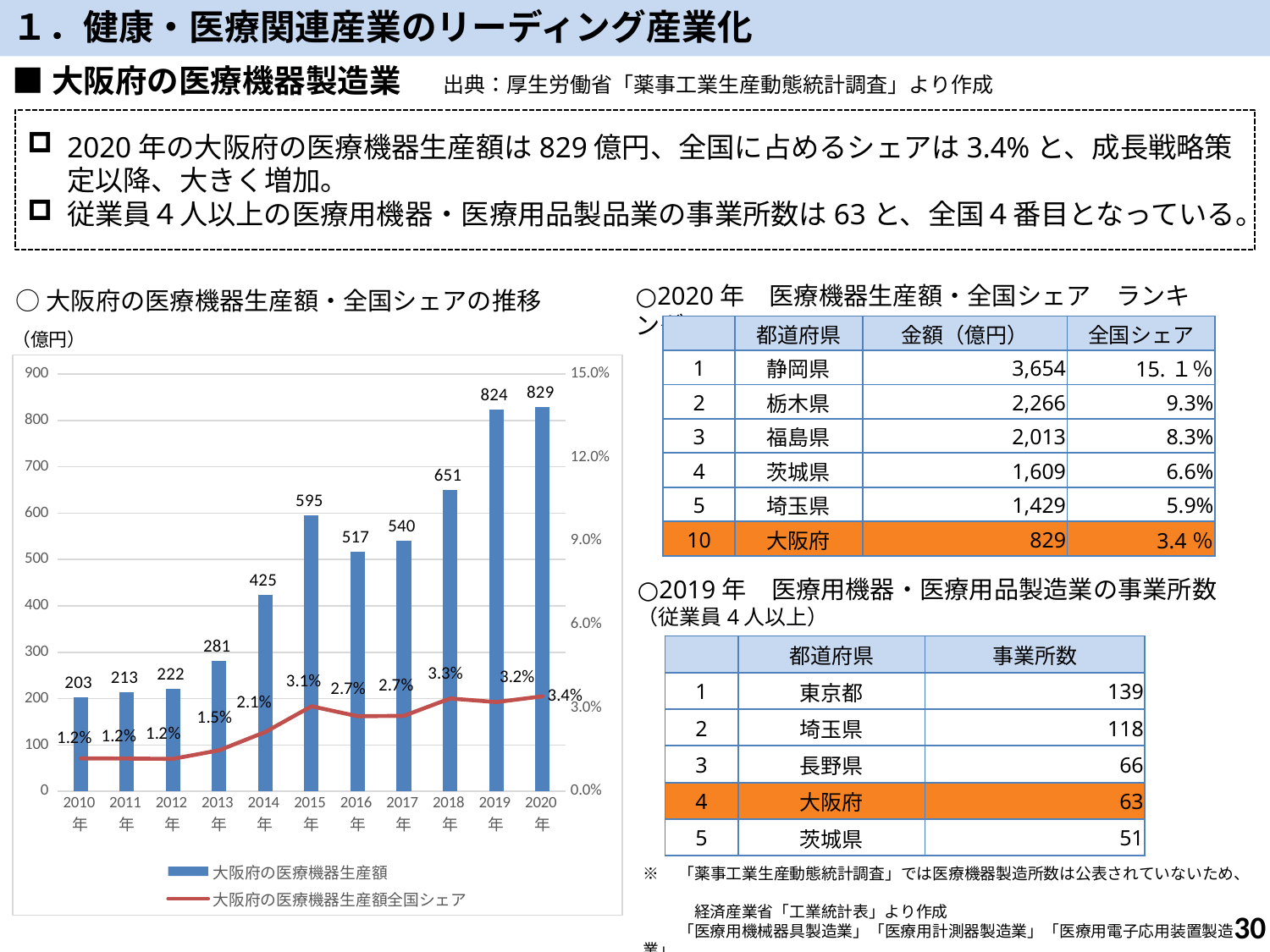
In the chart 大阪府の医療機器生産額・全国シェアの推移, what is the value of 大阪府の医療機器生産額 for 2020年? 829 What kind of chart is 大阪府の医療機器生産額・全国シェアの推移? Bar chart combined with a line chart In the chart 大阪府の医療機器生産額・全国シェアの推移, does 大阪府の医療機器生産額 generally rise or fall from 2010年 to 2020年? Rise In the chart 大阪府の医療機器生産額・全国シェアの推移, what is the difference between the 大阪府の医療機器生産額 values for 2020年 and 2010年? 626 In the chart 大阪府の医療機器生産額・全国シェアの推移, which year has the lowest 大阪府の医療機器生産額? 2010年 In the chart 大阪府の医療機器生産額・全国シェアの推移, how many years are shown on the x axis? 11 In the chart 大阪府の医療機器生産額・全国シェアの推移, how many series does the legend list? 2 In the chart 大阪府の医療機器生産額・全国シェアの推移, what is the 全国シェア value for 2020年? 3.4% In the chart 大阪府の医療機器生産額・全国シェアの推移, which year has the highest 大阪府の医療機器生産額? 2020年 In the chart 大阪府の医療機器生産額・全国シェアの推移, which year has the larger 大阪府の医療機器生産額, 2016年 or 2017年? 2017年 In the chart 大阪府の医療機器生産額・全国シェアの推移, what is the 全国シェア value for 2014年? 2.1% In the chart 大阪府の医療機器生産額・全国シェアの推移, what is the value of 大阪府の医療機器生産額 for 2015年? 595